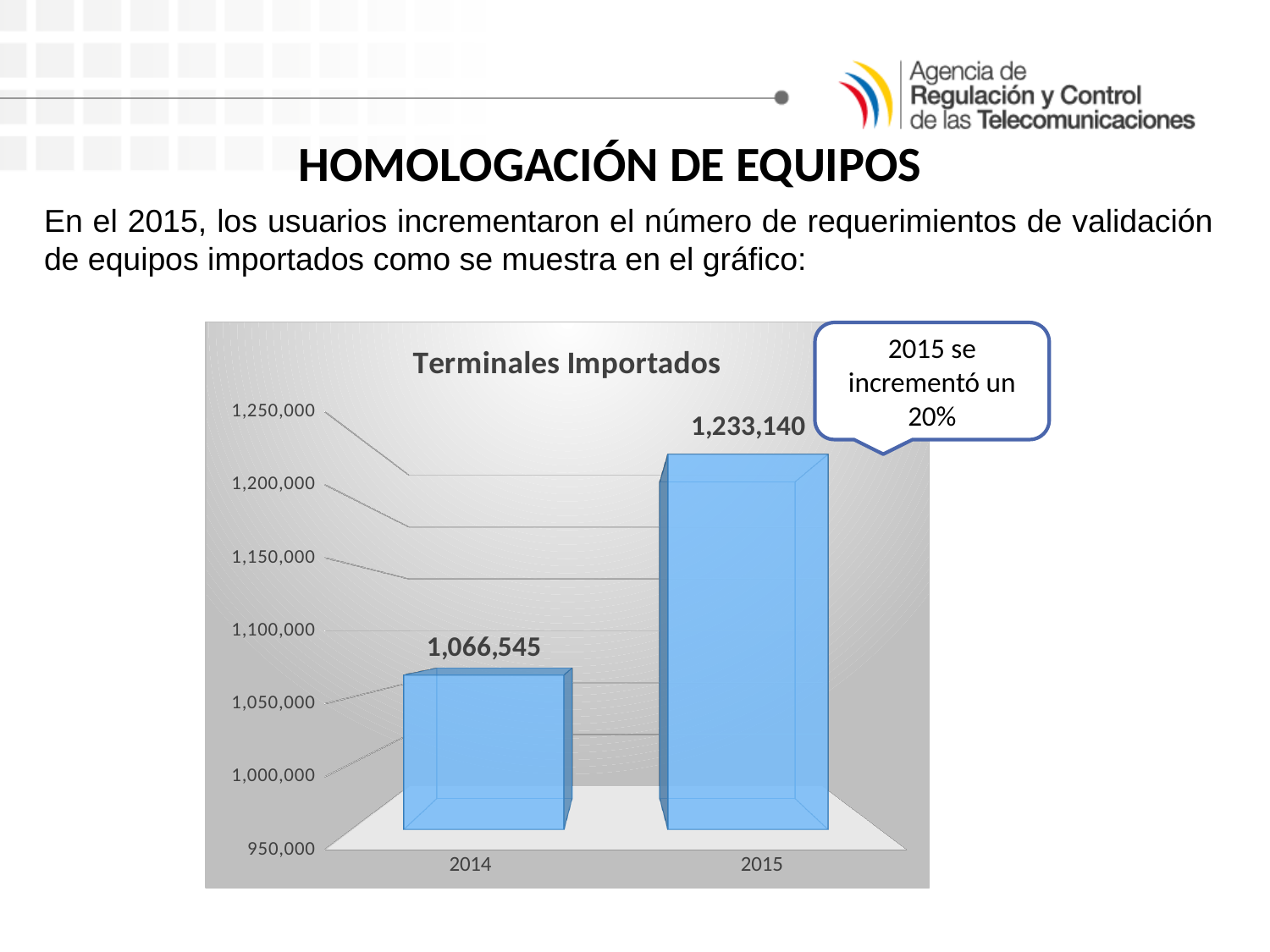
Which year has the lowest value in the chart? 2014 What is the title of the chart? Terminales Importados What is the value for 2014 in the Terminales Importados chart? 1,066,545 What is the value for 2015 in the Terminales Importados chart? 1,233,140 What kind of chart is shown on the slide? bar chart Do the values rise or fall from 2014 to 2015? rise Is the value for 2015 greater or less than 1,200,000? greater How many years are shown on the x axis of the chart? 2 Which is larger, the value for 2014 or the value for 2015? 2015 What is the difference between the 2015 and 2014 values? 166,595 Is the value for 2014 greater or less than 1,100,000? less Which year has the highest value in the chart? 2015